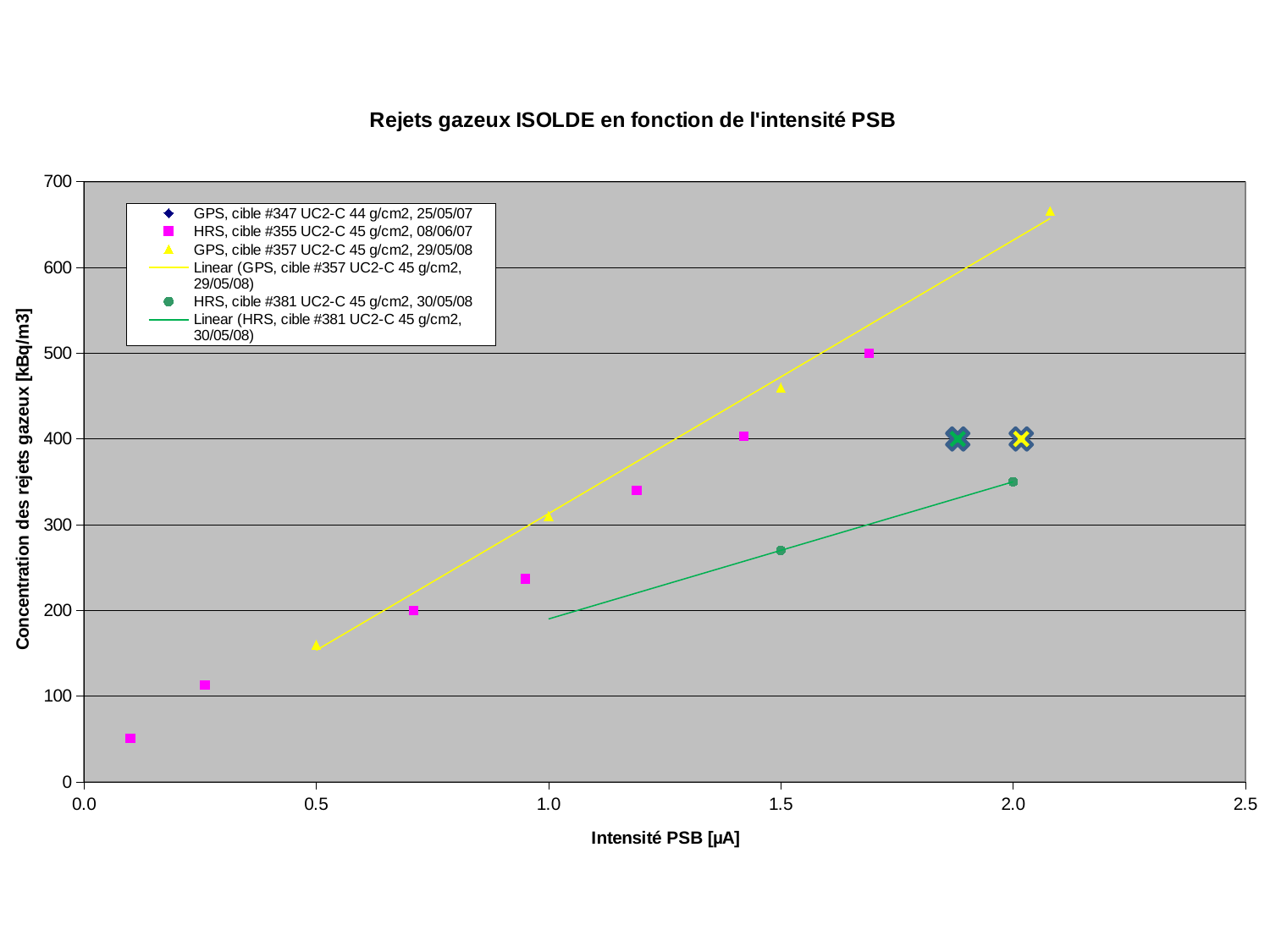
Which series contains the point with the highest concentration on the chart? GPS, cible #357 UC2-C 45 g/cm2, 29/05/08 How many data points are plotted for the series 'HRS, cible #381 UC2-C 45 g/cm2, 30/05/08'? 2 How many data points are plotted for the series 'HRS, cible #355 UC2-C 45 g/cm2, 08/06/07'? 7 What kind of chart is shown on the slide? scatter chart Is the concentration of the 'HRS, cible #381 UC2-C 45 g/cm2, 30/05/08' point at 1.5 µA greater or less than 300? less How many data points are plotted for the series 'GPS, cible #357 UC2-C 45 g/cm2, 29/05/08'? 4 What is the label of the y axis? Concentration des rejets gazeux [kBq/m3] How many entries does the chart's legend list? 6 At 1.5 µA, which series has the higher concentration: 'GPS, cible #357 UC2-C 45 g/cm2, 29/05/08' or 'HRS, cible #381 UC2-C 45 g/cm2, 30/05/08'? GPS, cible #357 UC2-C 45 g/cm2, 29/05/08 Is the concentration of the highest point of the series 'GPS, cible #357 UC2-C 45 g/cm2, 29/05/08' greater or less than 600? greater What is the title of the chart? Rejets gazeux ISOLDE en fonction de l'intensité PSB Do the concentration values rise or fall as the PSB intensity increases along the x axis? rise